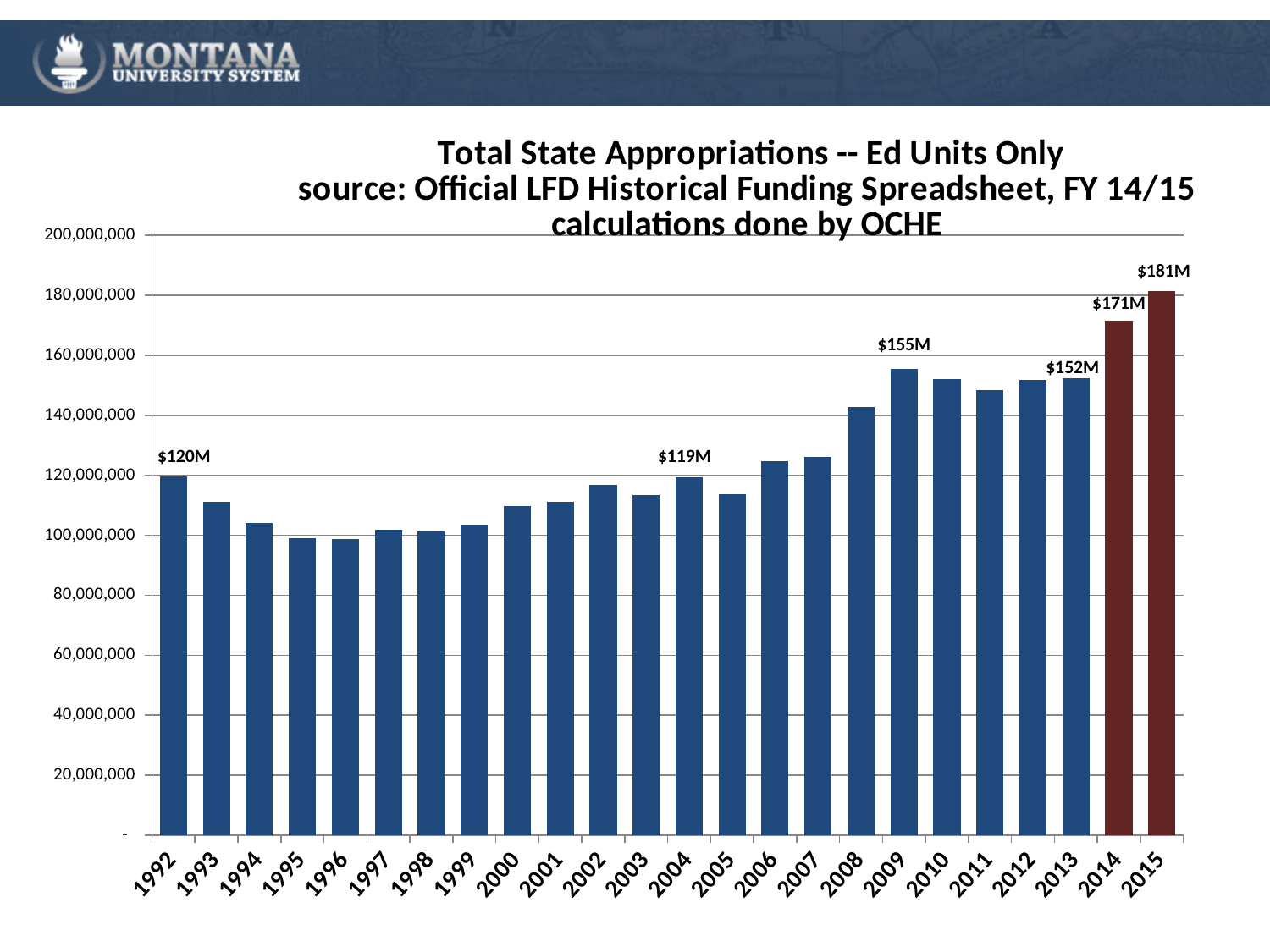
Which is larger, the value for 2009 or the value for 2013? 2009 Is the value for 2008 greater or less than 140,000,000? greater What is the difference between the 2015 value and the 2014 value? $10M What is the difference between the 2013 value and the 1992 value? $32M What is the value for 2009? $155M What is the value for 1992? $120M What kind of chart is this? bar chart Which year has the highest total state appropriation? 2015 What is the value for 2014? $171M How many years are shown on the x axis? 24 What is the value for 2015? $181M